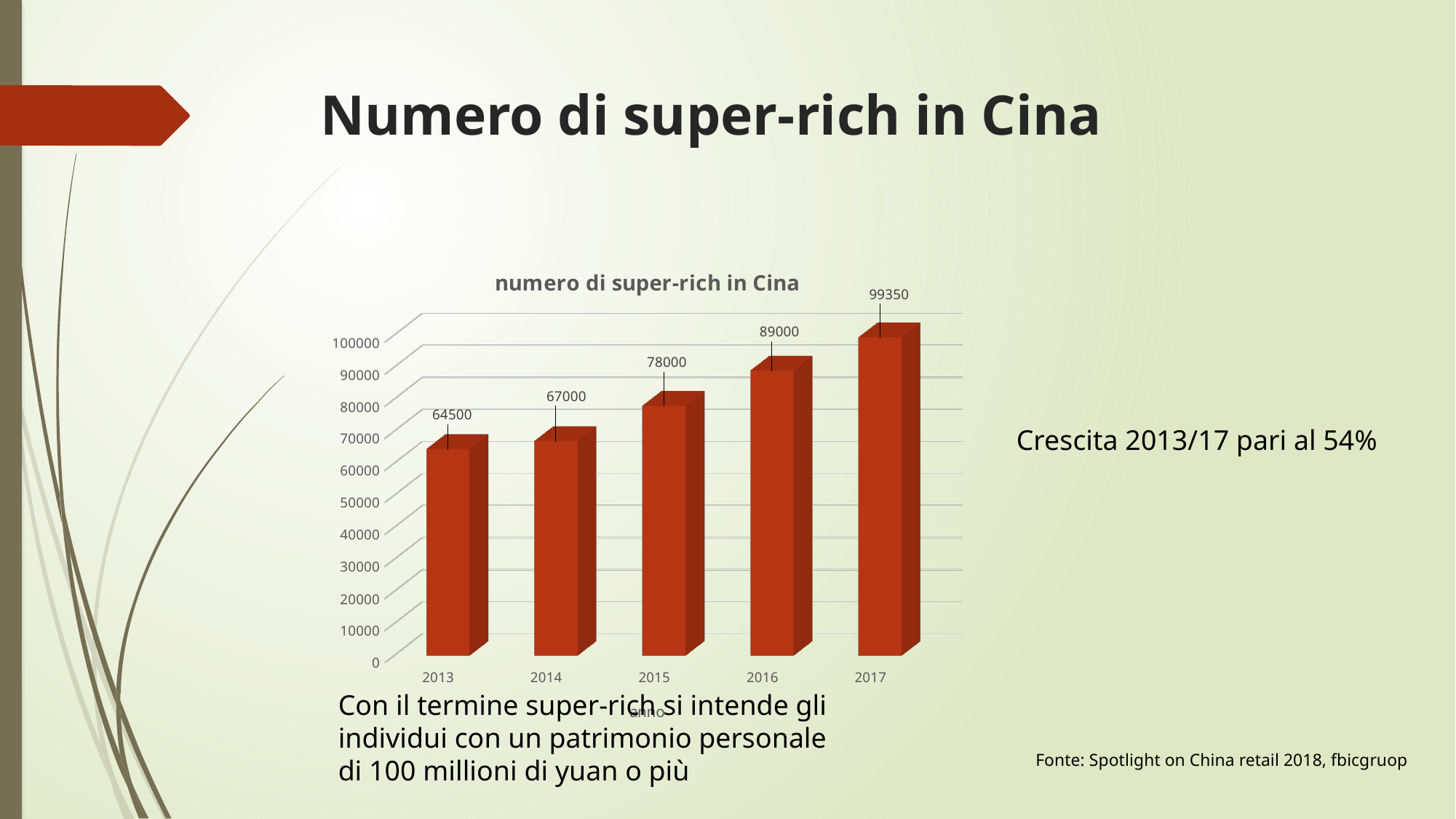
Is the value for 2016 greater or less than 80000? greater What is the value for 2013? 64500 What is the difference between the values for 2016 and 2015? 11000 How many years are shown on the x axis? 5 What is the difference between the values for 2017 and 2013? 34850 Which is larger, the value for 2014 or the value for 2016? 2016 What kind of chart is shown? bar chart Which year has the highest value? 2017 Which year has the lowest value? 2013 What is the value for 2015? 78000 Do the values rise or fall from 2013 to 2017? rise What is the value for 2017? 99350